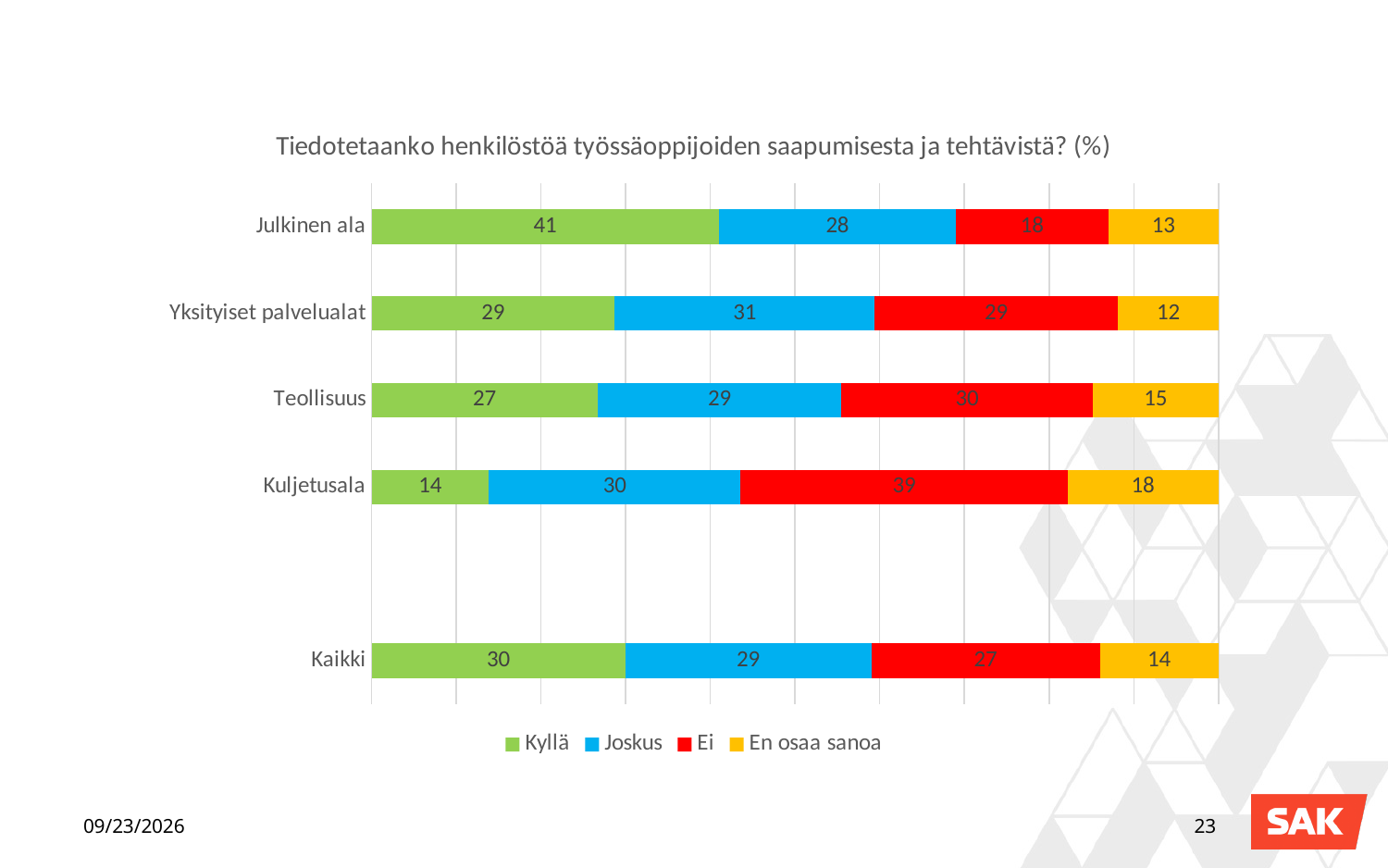
Which is larger, the Kyllä value for Kaikki or the Kyllä value for Teollisuus? Kaikki What is the total of the stacked bar for Julkinen ala? 100 What kind of chart is shown on the slide? Stacked bar chart Which category has the lowest Kyllä value? Kuljetusala What is the Kyllä value for Julkinen ala? 41 What is the Ei value for Kuljetusala? 39 How many categories are shown on the chart? 5 How many series does the legend list? 4 What is the difference between the Ei values for Kuljetusala and Julkinen ala? 21 What is the Joskus value for Yksityiset palvelualat? 31 Which category has the highest Kyllä value? Julkinen ala What is the En osaa sanoa value for Teollisuus? 15